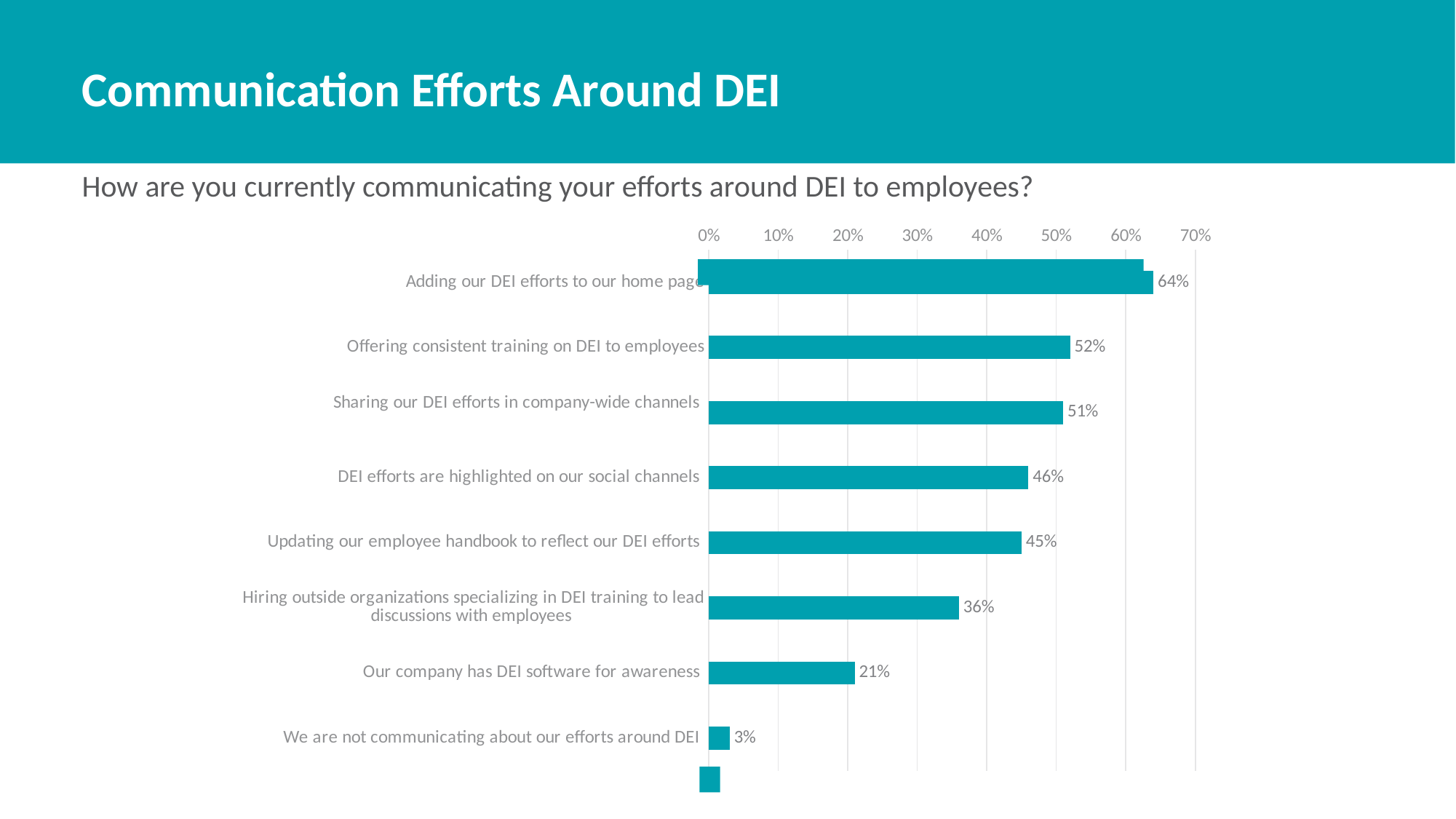
Which category has the highest value? Adding our DEI efforts to our home page What is the difference between 'Adding our DEI efforts to our home page' and 'Offering consistent training on DEI to employees'? 12% What is the difference between 'DEI efforts are highlighted on our social channels' and 'Our company has DEI software for awareness'? 25% What kind of chart is shown on the slide? Bar chart Which is larger: 'Sharing our DEI efforts in company-wide channels' or 'Updating our employee handbook to reflect our DEI efforts'? Sharing our DEI efforts in company-wide channels What is the value for 'Offering consistent training on DEI to employees'? 52% What is the value for 'Hiring outside organizations specializing in DEI training to lead discussions with employees'? 36% What percentage of respondents say their company has DEI software for awareness? 21% How many labeled categories are shown in the chart? 8 What is the highest value shown on the percentage axis? 70% What percentage of respondents are adding their DEI efforts to their home page? 64% Which category has the lowest value? We are not communicating about our efforts around DEI